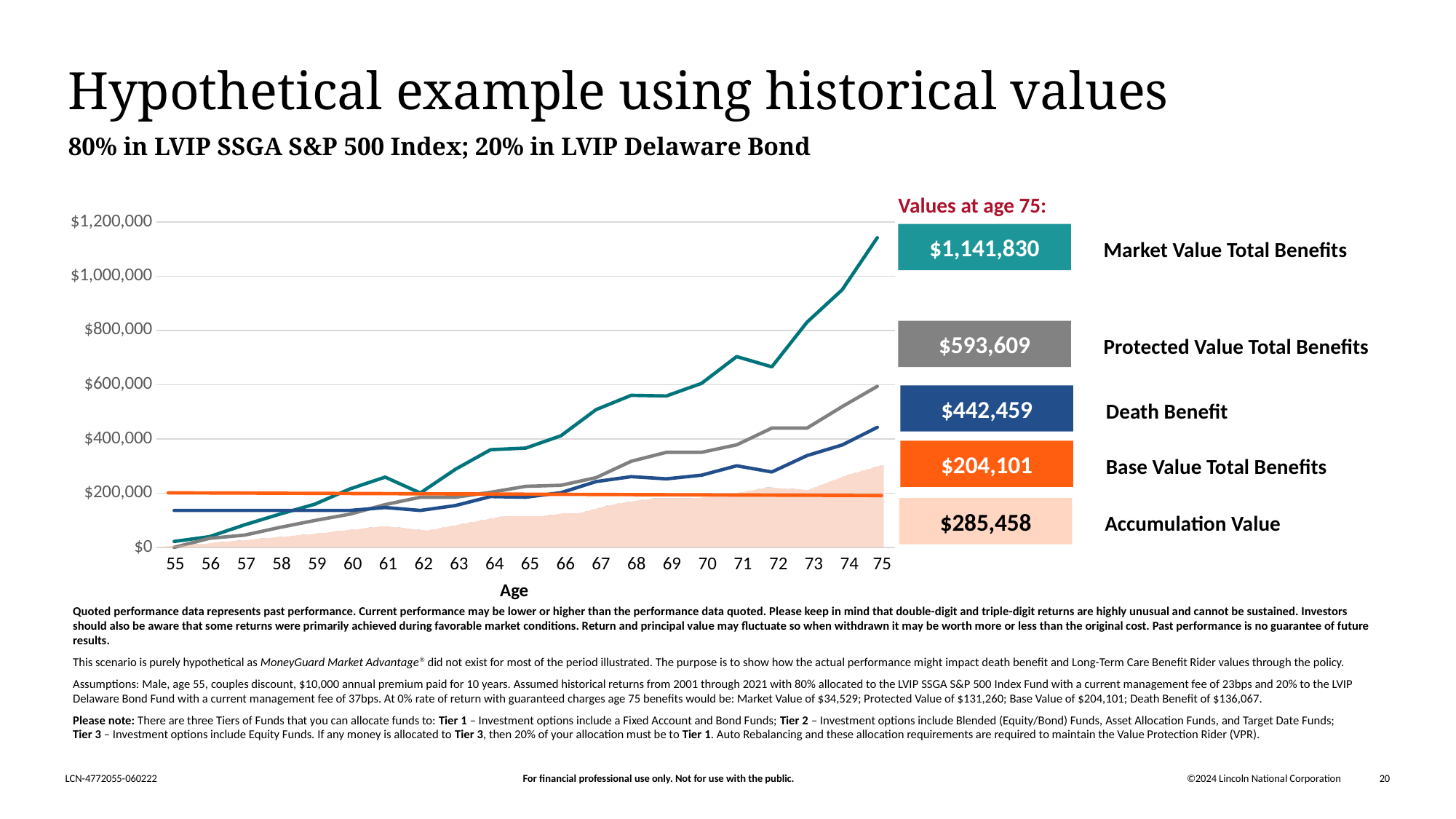
What is the Death Benefit at age 75? $442,459 Which series has the highest value at age 75? Market Value Total Benefits Which series has the lowest value at age 75? Base Value Total Benefits Does the Market Value Total Benefits line generally rise or fall from age 55 to age 75? rise How many ages are shown on the x axis? 21 What is the Accumulation Value at age 75? $285,458 What is the Market Value Total Benefits at age 75? $1,141,830 Is the Market Value Total Benefits at age 65 greater or less than $200,000? greater Is the Death Benefit at age 55 greater or less than $200,000? less What is the difference between the Market Value Total Benefits and the Protected Value Total Benefits at age 75? $548,221 What is the Protected Value Total Benefits at age 75? $593,609 At age 75, which is larger: the Death Benefit or the Accumulation Value? Death Benefit